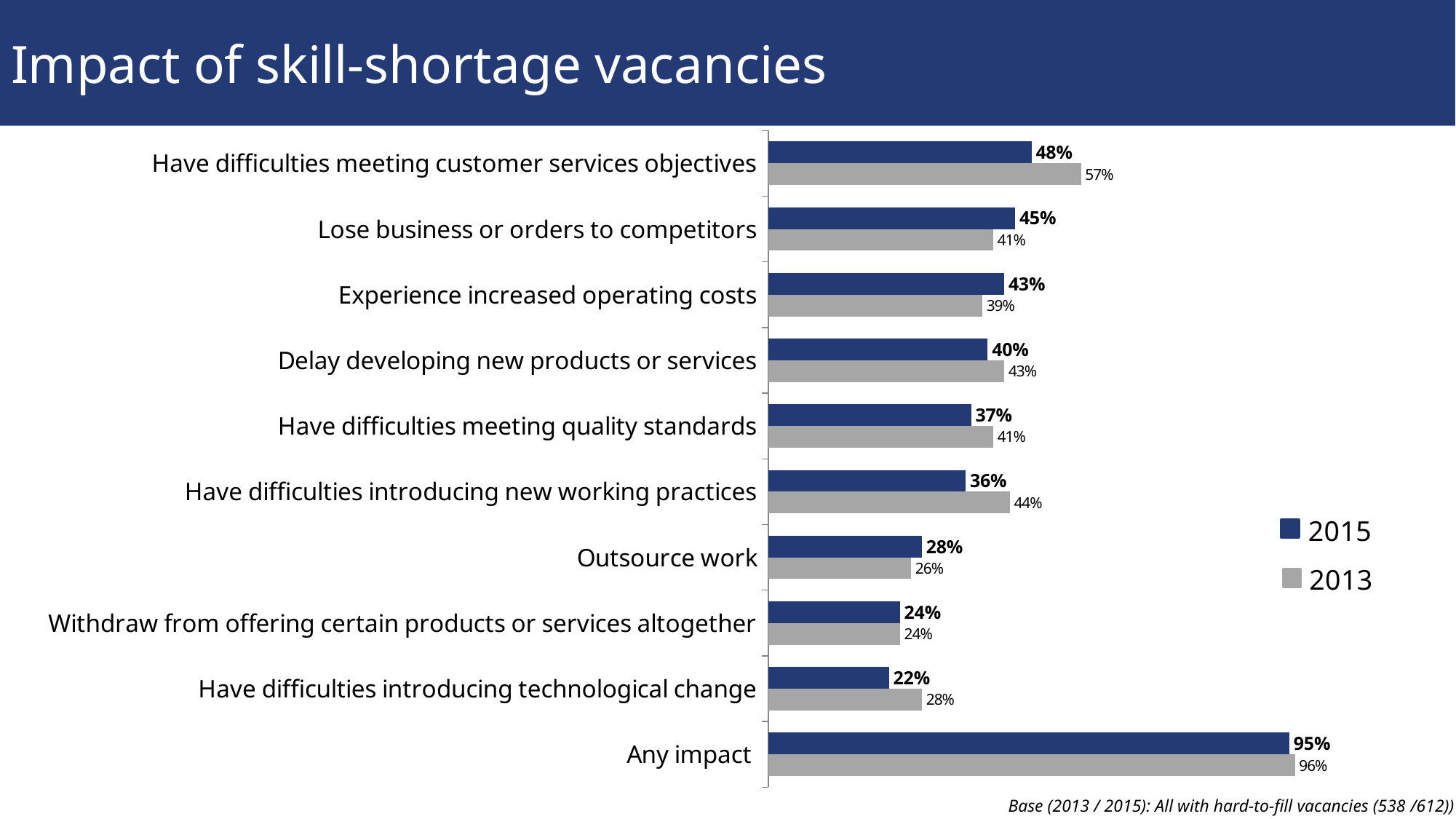
Which category has the highest 2015 value? Any impact What is the difference between the 2013 and 2015 values for 'Have difficulties meeting customer services objectives'? 9% Which category has the lowest 2015 value? Have difficulties introducing technological change Which is larger for 'Have difficulties introducing new working practices', the 2015 value or the 2013 value? 2013 What is the 2015 value for 'Have difficulties meeting customer services objectives'? 48% Which colour represents the 2013 series in the chart? Grey What is the 2015 value for 'Outsource work'? 28% What is the 2013 value for 'Lose business or orders to competitors'? 41% How many categories are shown on the chart? 10 What kind of chart is shown on the slide? Bar chart What is the difference between the 2015 and 2013 values for 'Have difficulties introducing technological change'? 6% How many series does the legend list? 2